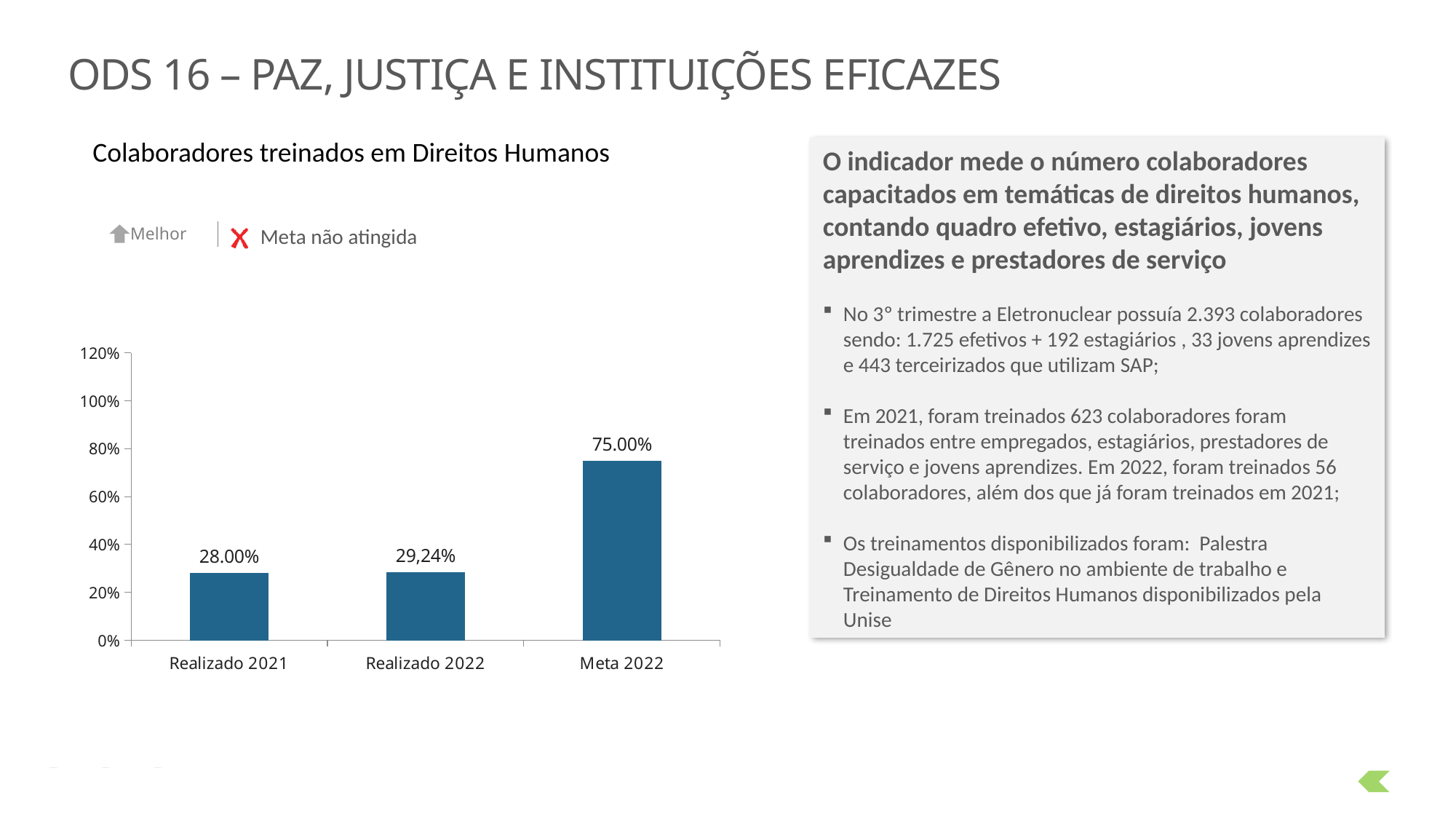
Which is larger, Realizado 2022 or Meta 2022? Meta 2022 What is the value for Meta 2022? 75.00% Is the value for Meta 2022 greater or less than 60%? greater Which category has the highest value? Meta 2022 What is the difference between Meta 2022 and Realizado 2022? 45.76% What is the title of the chart? Colaboradores treinados em Direitos Humanos What is the difference between Meta 2022 and Realizado 2021? 47.00% What is the value for Realizado 2022? 29,24% What kind of chart is shown on the slide? Bar chart What is the value for Realizado 2021? 28.00% How many categories are shown on the x axis? 3 Which category has the lowest value? Realizado 2021